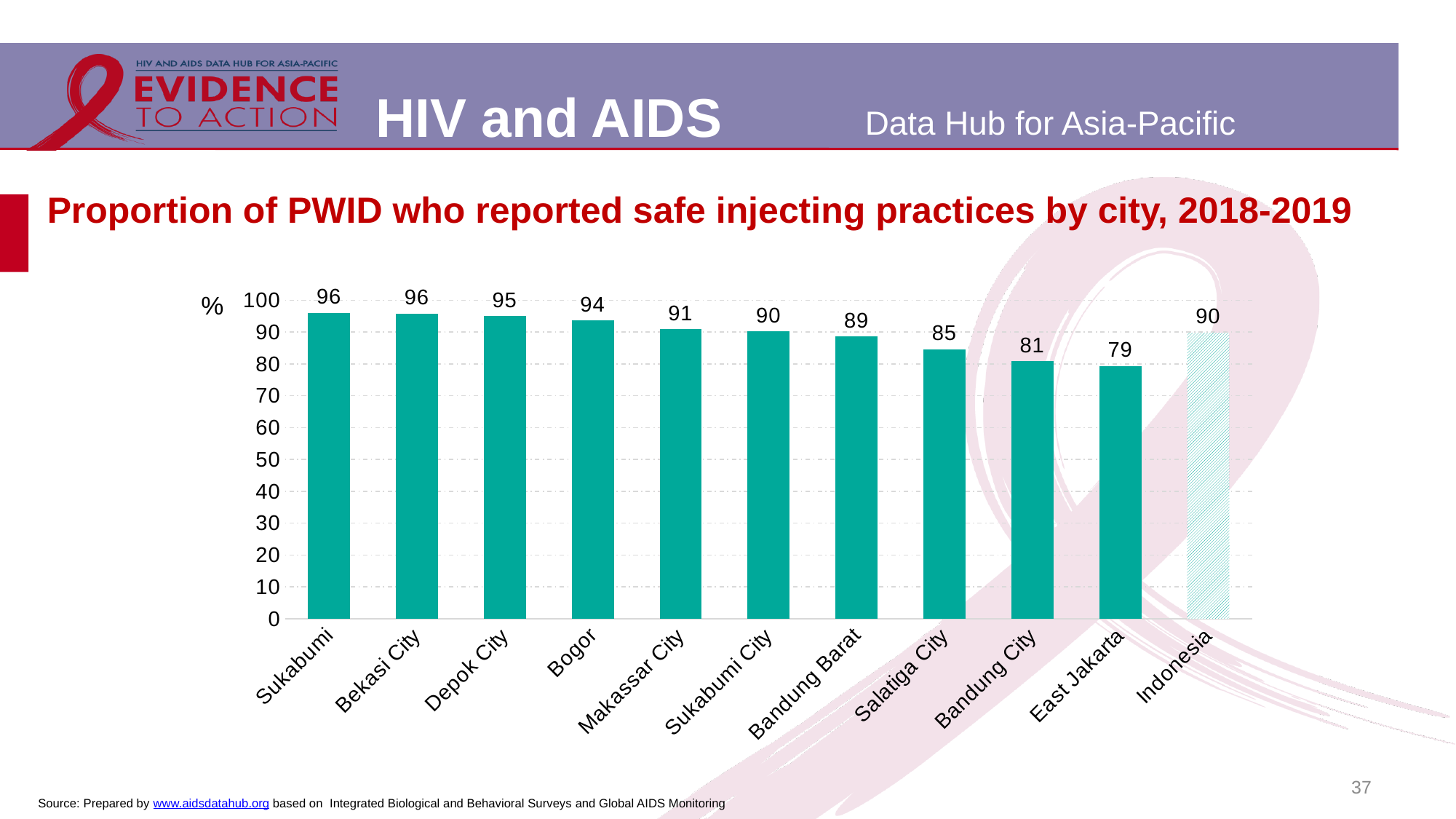
Which is larger, the value for Sukabumi City or the value for Salatiga City? Sukabumi City What is the difference between the values for Makassar City and East Jakarta? 12 What is the value for Indonesia? 90 What kind of chart is shown on the slide? bar chart What is the value for Bogor? 94 What is the difference between the values for Depok City and Bandung City? 14 What is the title of the chart? Proportion of PWID who reported safe injecting practices by city, 2018-2019 What is the value for Bandung Barat? 89 Which city has the lowest value? East Jakarta How many categories are shown on the x axis? 11 What is the value for Salatiga City? 85 Is the value for East Jakarta greater or less than 80? less